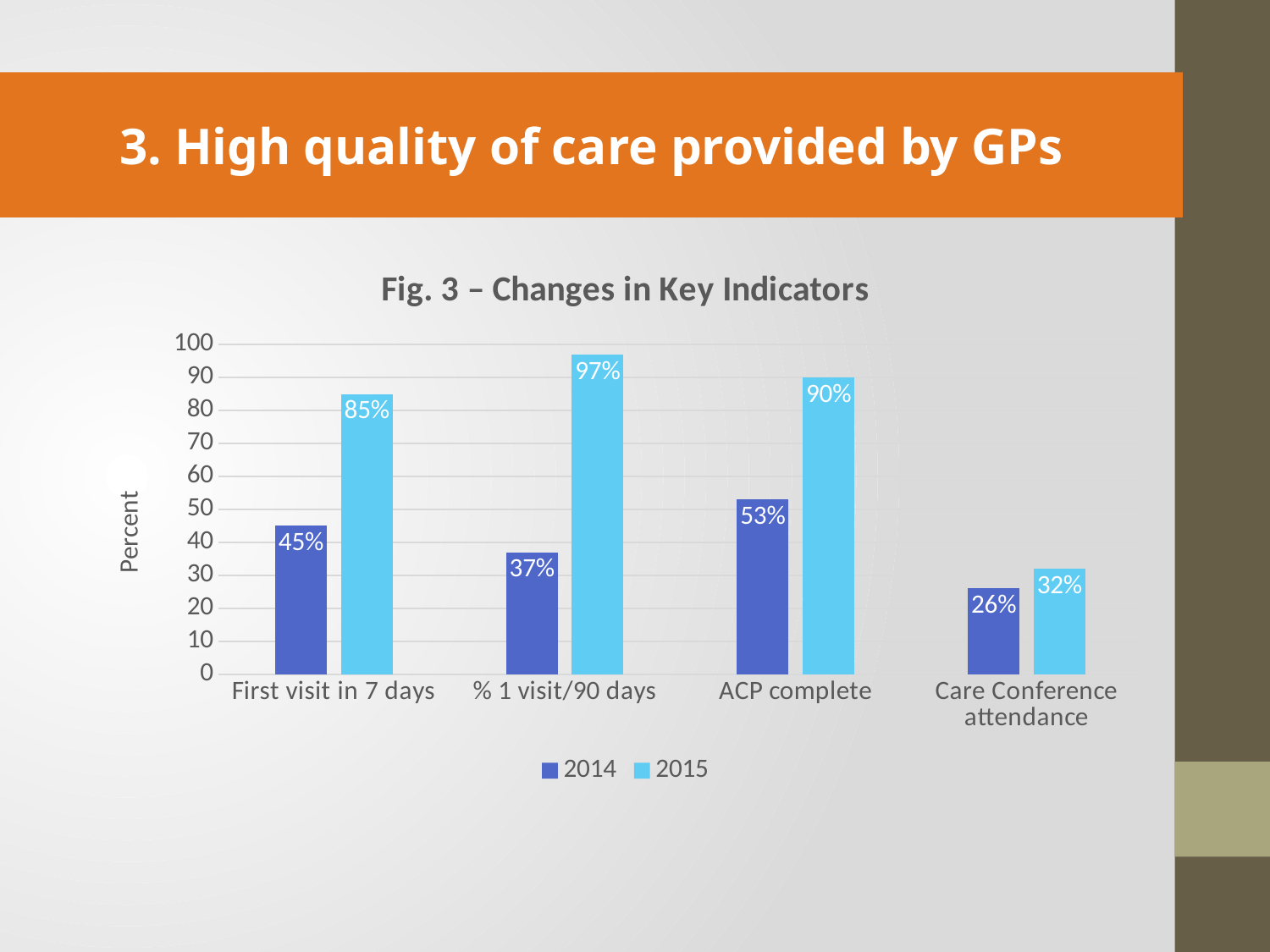
What kind of chart is shown? Bar chart How many categories are shown on the x axis? 4 Which category has the highest 2015 value? % 1 visit/90 days What is the 2015 value for First visit in 7 days? 85% Which category has the lowest 2014 value? Care Conference attendance What is the 2014 value for ACP complete? 53% Which is larger: the 2014 value for First visit in 7 days or the 2014 value for % 1 visit/90 days? First visit in 7 days What is the difference between the 2015 and 2014 values for % 1 visit/90 days? 60% What is the label on the vertical axis? Percent What is the 2015 value for Care Conference attendance? 32% How many series does the legend list? 2 What is the title of the chart? Fig. 3 – Changes in Key Indicators